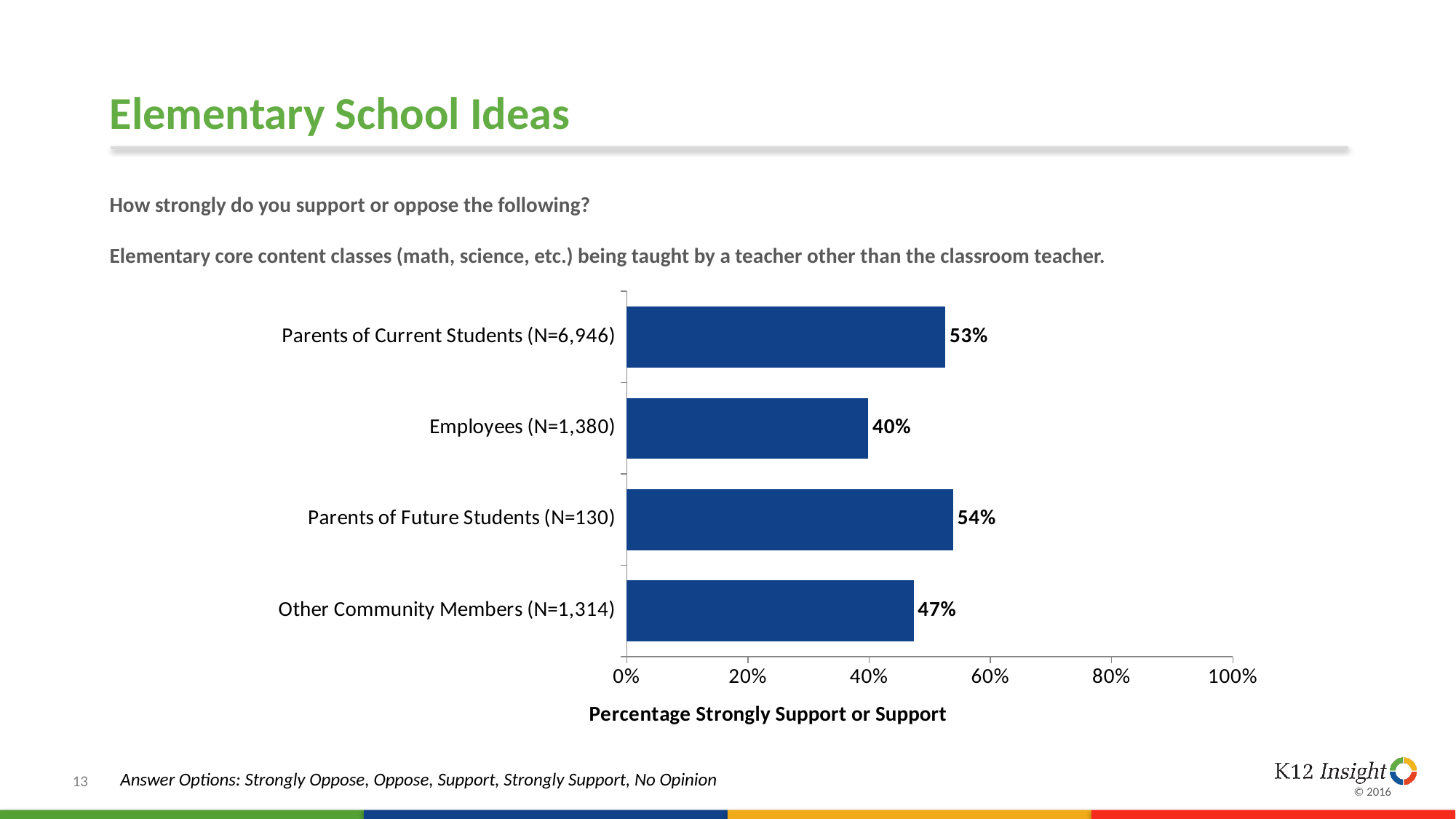
What is the difference in percentage points between Parents of Current Students and Other Community Members? 6 Which group has the highest percentage of strongly support or support? Parents of Future Students (N=130) What percentage of Parents of Current Students strongly support or support elementary core content classes being taught by a teacher other than the classroom teacher? 53% Which group has the lowest percentage of strongly support or support? Employees (N=1,380) What is the difference in percentage points between Parents of Future Students and Employees? 14 What kind of chart is shown on the slide? Bar chart How many respondent groups are shown in the chart? 4 Which group has a larger value, Employees or Other Community Members? Other Community Members What is the value shown for Employees (N=1,380)? 40% Is the value for Other Community Members greater or less than 60%? less What is the label on the horizontal axis of the chart? Percentage Strongly Support or Support What is the value shown for Other Community Members (N=1,314)? 47%